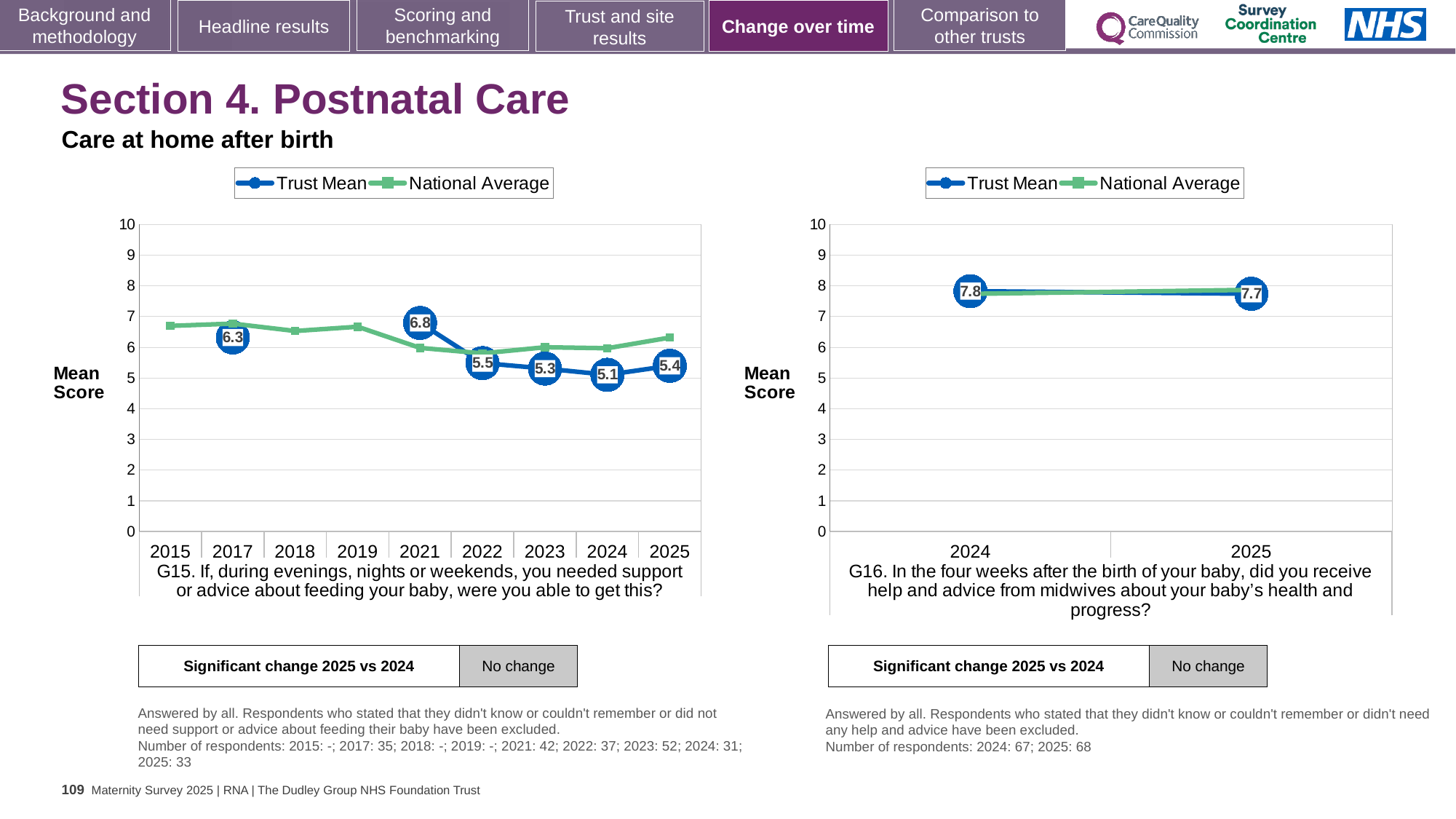
In the G15 chart on the left, what is the Trust Mean score for 2025? 5.4 In the G15 chart on the left, is the National Average value for 2015 greater or less than 6? greater In the G15 chart on the left, is the Trust Mean score higher in 2017 or in 2024? 2017 How many series does the legend of the G16 chart on the right list? 2 In the G15 chart on the left, what is the Trust Mean score for 2021? 6.8 How many years are shown on the x axis of the G15 chart on the left? 9 What kind of chart is the G16 chart on the right? Line chart In the G16 chart on the right, what is the Trust Mean score for 2024? 7.8 In the G16 chart on the right, what is the difference between the Trust Mean scores for 2024 and 2025? 0.1 In the G15 chart on the left, which year has the lowest labelled Trust Mean score? 2024 In the G15 chart on the left, which year has the highest labelled Trust Mean score? 2021 In the G15 chart on the left, what is the difference between the Trust Mean scores for 2021 and 2025? 1.4